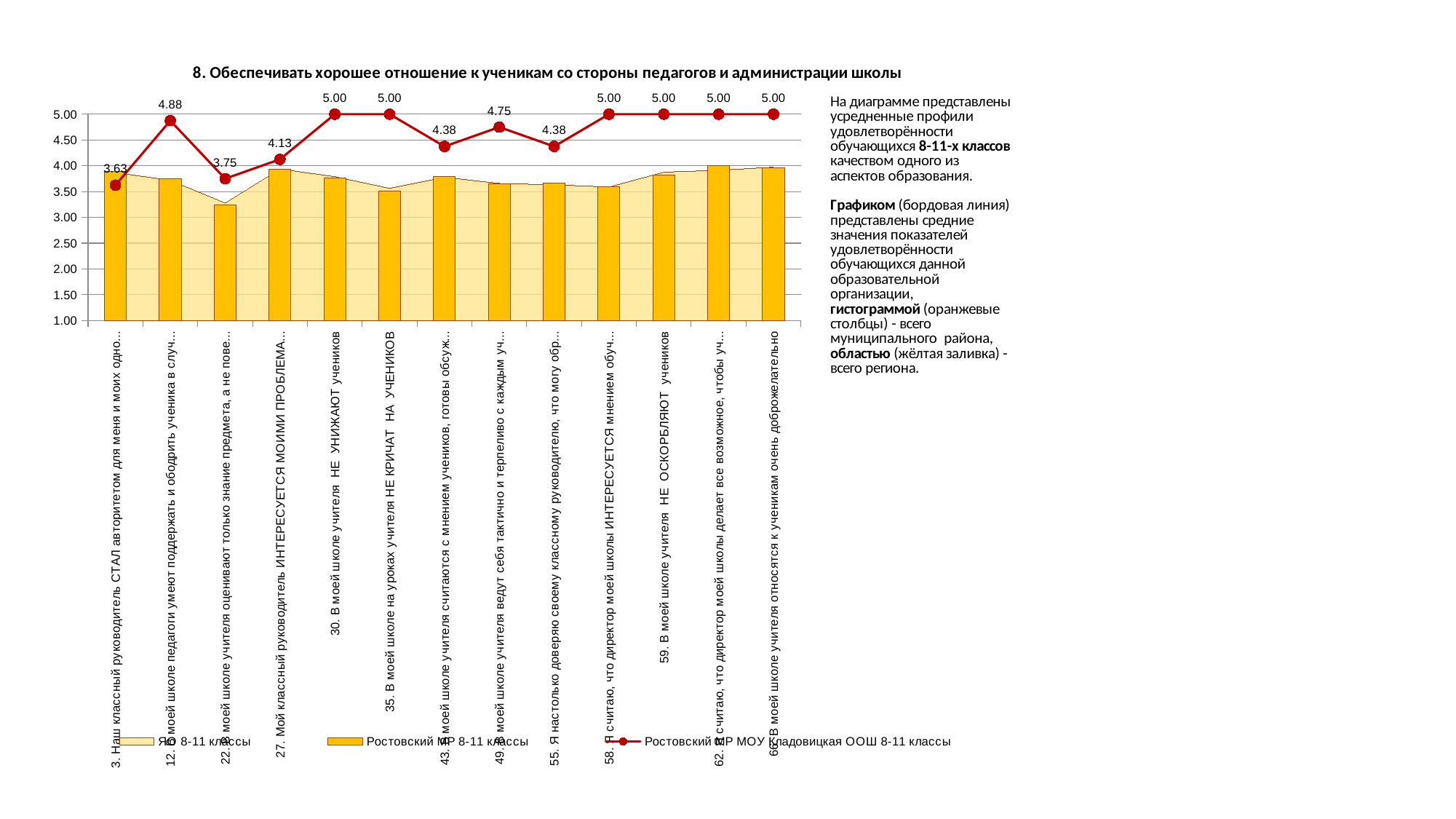
What value does the maroon line (Ростовский МР МОУ Кладовицкая ООШ 8-11 классы) show for statement 12 (В моей школе педагоги умеют поддержать и ободрить ученика...)? 4.88 What is the difference between the maroon line values for statement 30 and statement 43? 0.62 How many statements (categories) are plotted along the x axis? 13 Is the orange bar (Ростовский МР 8-11 классы) for statement 22 greater or less than 3.50? less Is the orange bar (Ростовский МР 8-11 классы) for statement 27 greater or less than 3.50? greater What is the difference between the maroon line values for statement 12 and statement 3? 1.25 How many series does the legend list? 3 What value does the maroon line show for statement 27 (Мой классный руководитель ИНТЕРЕСУЕТСЯ МОИМИ ПРОБЛЕМА...)? 4.13 For statement 12, which is larger: the maroon line value (Кладовицкая ООШ) or the orange bar (Ростовский МР)? the maroon line value For which statement does the maroon line (Кладовицкая ООШ) have its lowest value? 3. Наш классный руководитель СТАЛ авторитетом для меня и моих одно… Which statement has the lowest orange bar (Ростовский МР 8-11 классы)? 22. В моей школе учителя оценивают только знание предмета, а не пове… What value does the maroon line show for statement 49 (В моей школе учителя ведут себя тактично и терпеливо...)? 4.75